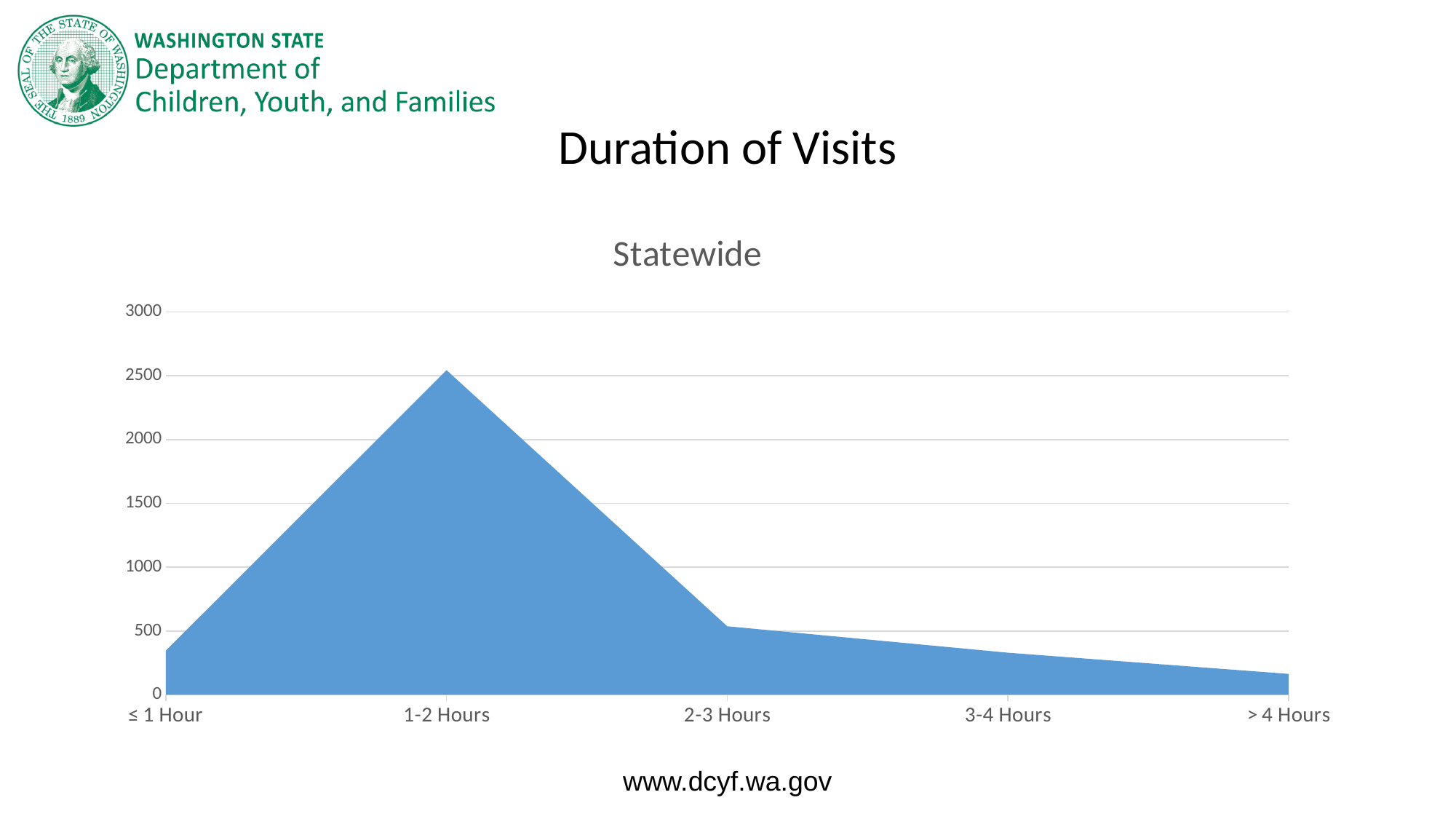
Which duration category has the lowest value? > 4 Hours How many duration categories are shown on the x axis? 5 Is the value for 2-3 Hours greater or less than 1000? less Which is larger, the value for 3-4 Hours or the value for > 4 Hours? 3-4 Hours Which is larger, the value for ≤ 1 Hour or the value for 2-3 Hours? 2-3 Hours Which duration category has the highest value? 1-2 Hours What is the title of the chart? Statewide Is the value for ≤ 1 Hour greater or less than 500? less Is the value for > 4 Hours greater or less than 500? less What kind of chart is shown on the slide? Area chart Do the values rise or fall from 1-2 Hours to > 4 Hours? fall